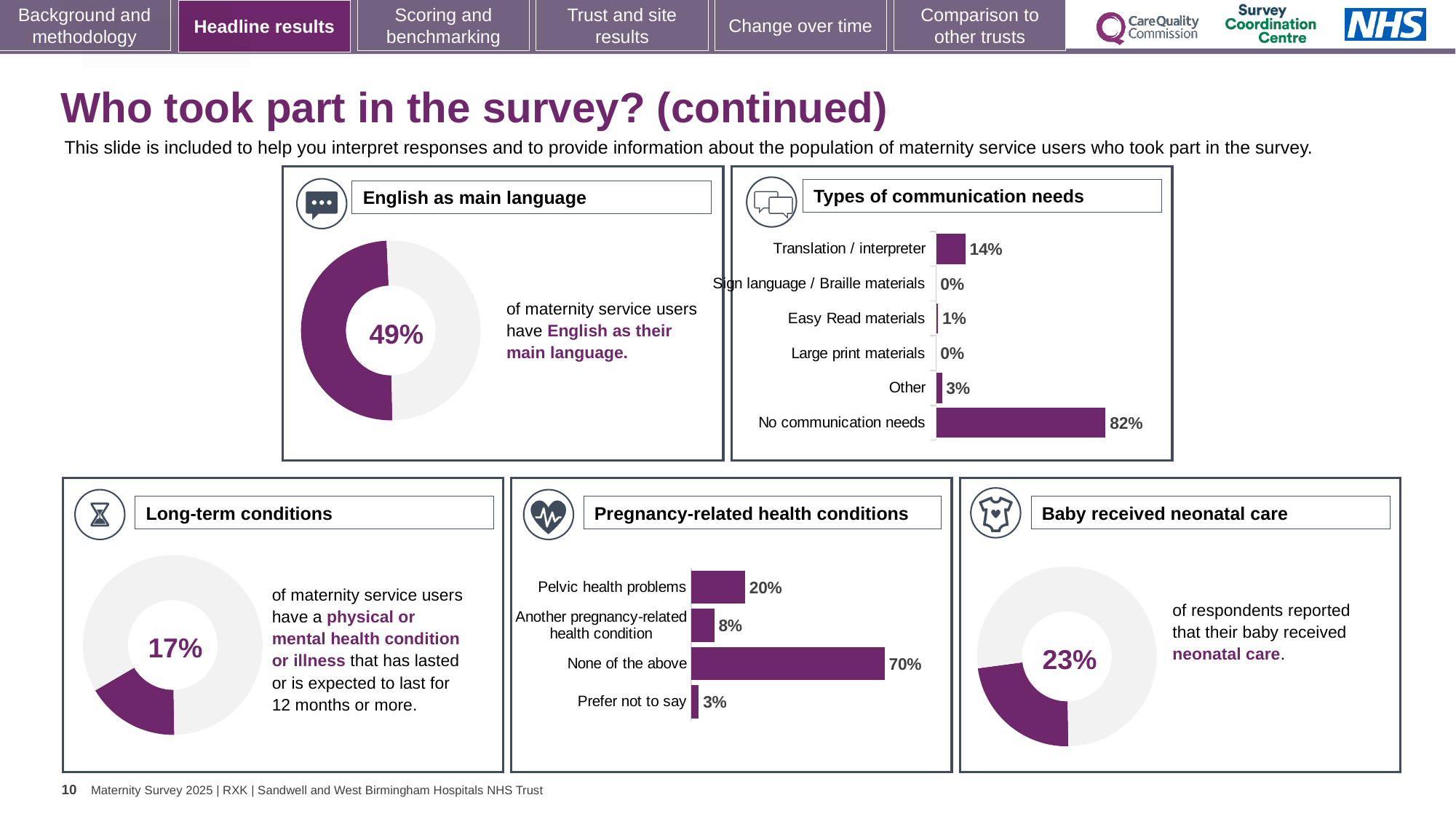
In the 'Types of communication needs' chart, what is the difference between No communication needs and Translation / interpreter? 68% What percentage is shown in the 'English as main language' donut chart? 49% In the 'Pregnancy-related health conditions' chart, which is larger: Pelvic health problems or Another pregnancy-related health condition? Pelvic health problems What percentage is shown in the 'Long-term conditions' donut chart? 17% In the 'Pregnancy-related health conditions' chart, what is the difference between None of the above and Pelvic health problems? 50% In the 'Pregnancy-related health conditions' chart, what is the value for Pelvic health problems? 20% In the 'Types of communication needs' chart, which category has the highest value? No communication needs In the 'Pregnancy-related health conditions' chart, which category has the lowest value? Prefer not to say How many categories are shown in the 'Types of communication needs' chart? 6 In the 'Types of communication needs' chart, what is the value for Translation / interpreter? 14% What kind of chart is the 'Types of communication needs' chart? Bar chart What percentage of respondents reported that their baby received neonatal care, according to the 'Baby received neonatal care' chart? 23%